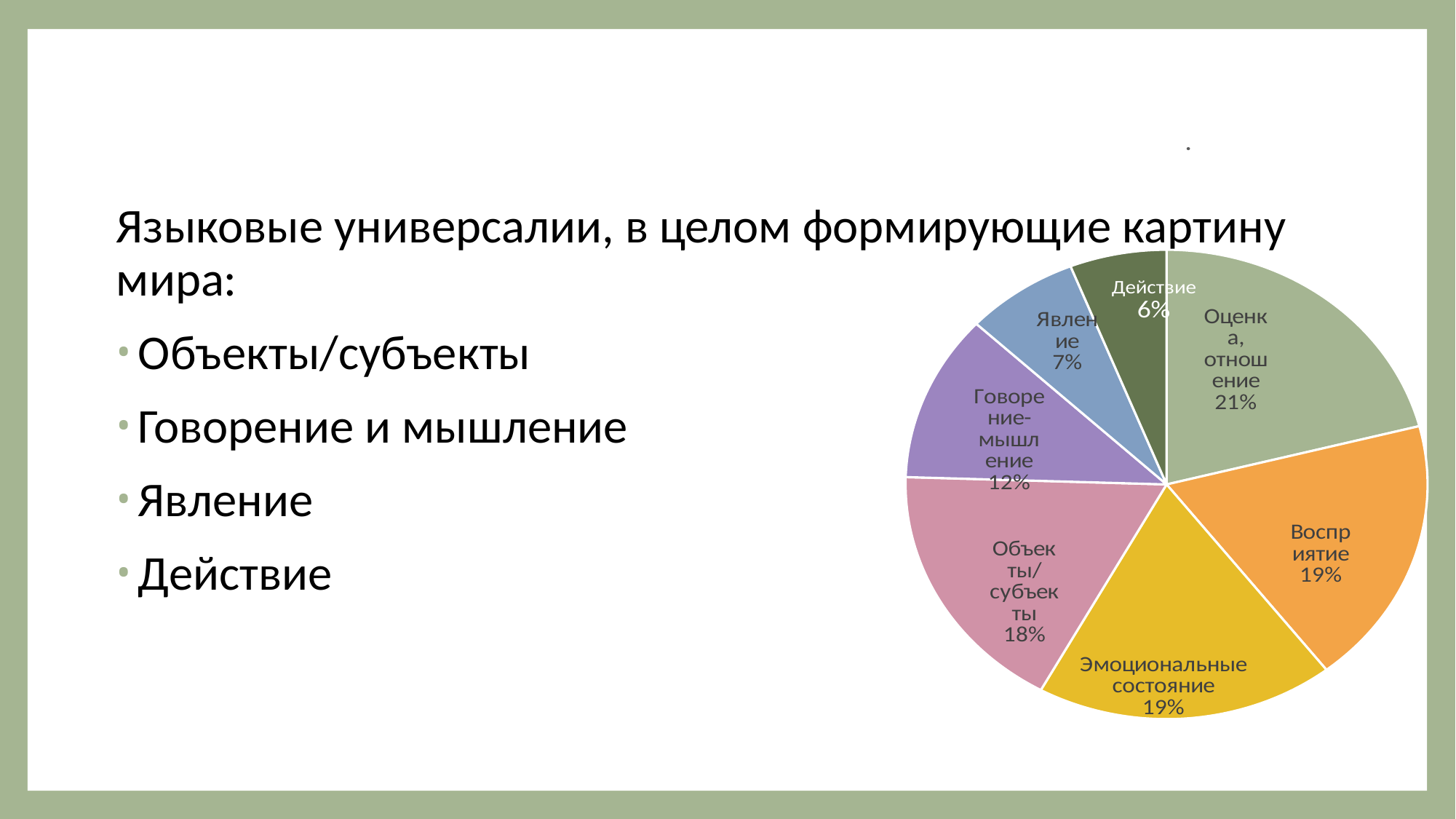
Which slice is larger, "Объекты/субъекты" or "Говорение-мышление"? Объекты/субъекты What percentage does the slice "Действие" show? 6% What is the difference in percentage points between "Оценка, отношение" and "Явление"? 14 What percentage does the slice "Восприятие" show? 19% What percentage does the slice "Объекты/субъекты" show? 18% How many slices does the pie chart have? 7 What percentage does the slice "Оценка, отношение" show? 21% Which slice has the smallest share of the pie? Действие What is the combined share of "Явление" and "Действие"? 13% What kind of chart is shown on the slide? pie chart What percentage does the slice "Говорение-мышление" show? 12% Which slice has the largest share of the pie? Оценка, отношение